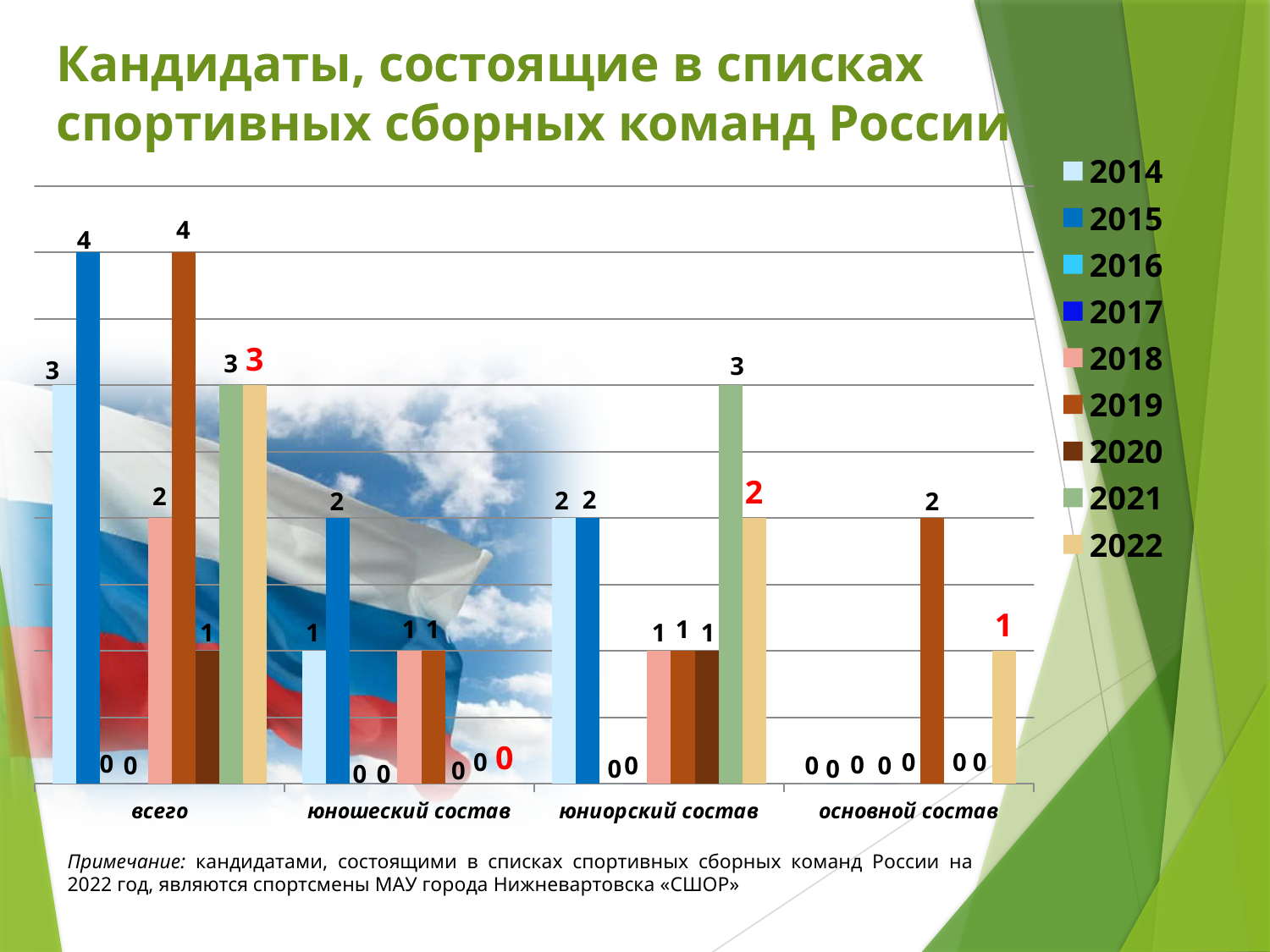
What is the value for 2015 in the 'всего' category? 4 Which year has the highest value in the 'юниорский состав' category? 2021 Which year has the highest value in the 'юношеский состав' category? 2015 What type of chart is shown on the slide? bar chart Which year is shown last in the legend? 2022 What is the value for 2019 in the 'основной состав' category? 2 Which is larger in the 'основной состав' category: the value for 2019 or the value for 2022? 2019 What is the value for 2021 in the 'юниорский состав' category? 3 How many categories are shown on the x axis? 4 How many series does the legend list? 9 What is the difference between the 2019 and 2018 values in the 'всего' category? 2 What is the value for 2022 in the 'юниорский состав' category? 2